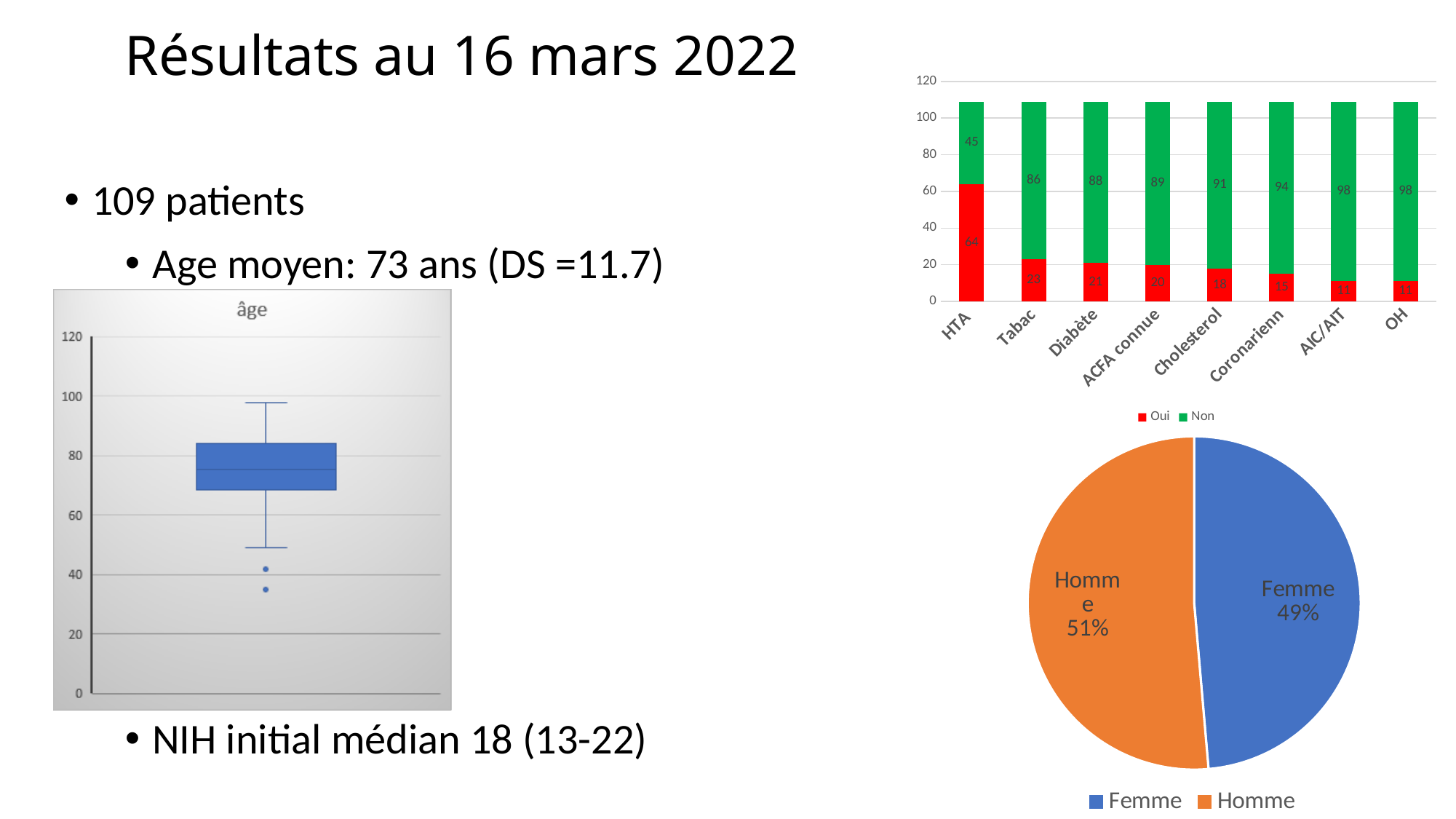
What kind of chart is the chart titled 'âge' on the left of the slide? box plot In the stacked bar chart at the top right, what is the 'Non' value for Cholesterol? 91 In the stacked bar chart at the top right, what is the total of the stacked bar for Tabac? 109 How many categories are shown on the x axis of the stacked bar chart at the top right? 8 In the stacked bar chart at the top right, which category has the lowest 'Non' value? HTA In the stacked bar chart at the top right, which category has the highest 'Oui' value? HTA How many series does the legend of the stacked bar chart at the top right list? 2 In the pie chart at the bottom right, which slice is larger, Femme or Homme? Homme In the pie chart at the bottom right, what share is Homme? 51% In the stacked bar chart at the top right, is the 'Oui' value for ACFA connue larger or smaller than the 'Oui' value for Coronarienn? larger In the stacked bar chart at the top right, what is the difference between the 'Oui' values for Tabac and Diabète? 2 In the stacked bar chart at the top right, what is the 'Oui' value for HTA? 64